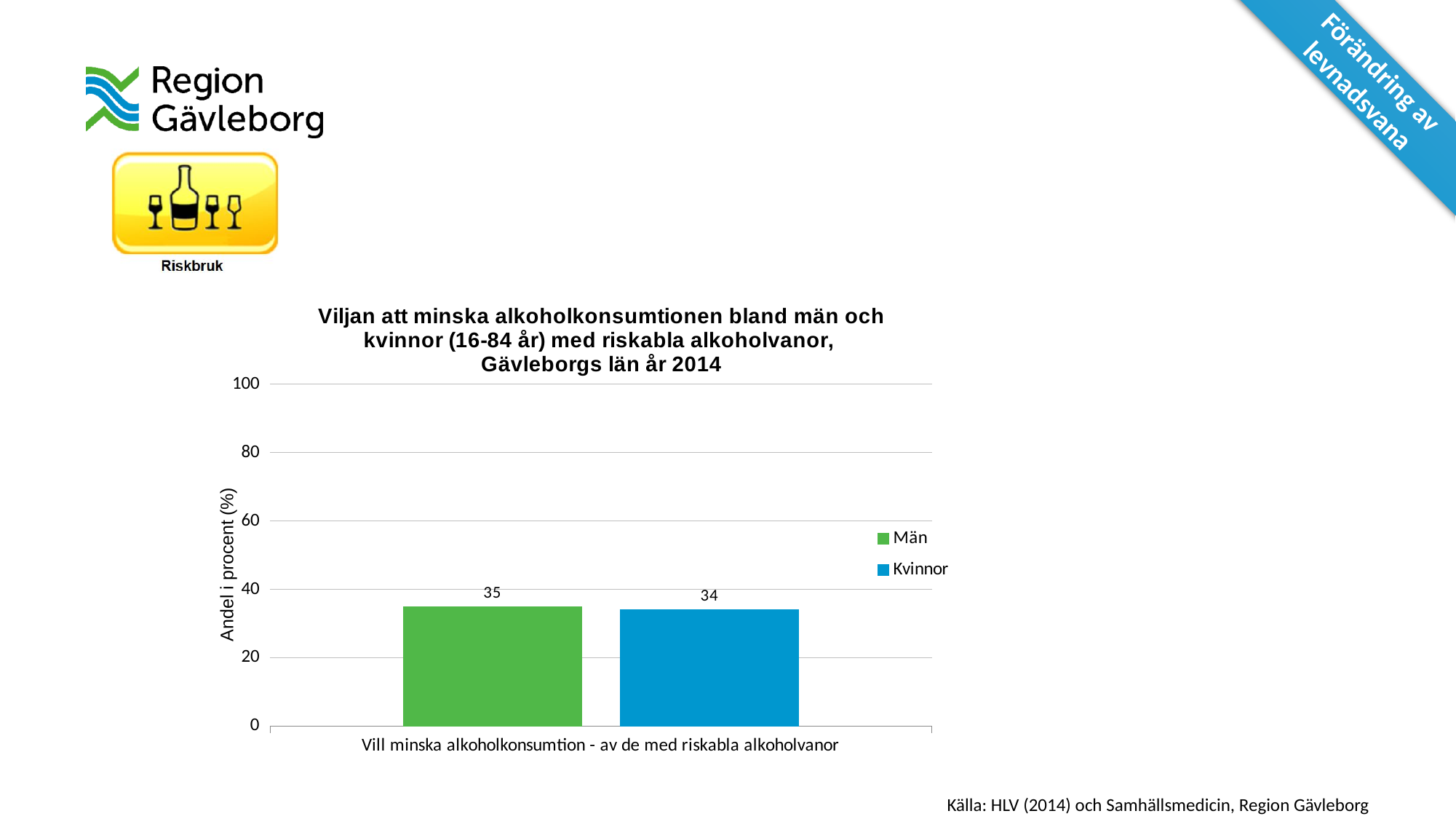
What is the value for Män in the chart? 35 What colour is the bar for Kvinnor? blue What is the difference between the values for Män and Kvinnor? 1 What is the highest value shown on the y axis? 100 How many series does the legend list? 2 How many categories are shown on the x axis? 1 Is the value for Kvinnor greater or less than 20? greater Is the value for Män greater or less than 40? less What kind of chart is shown on the slide? bar chart Which series has the higher value, Män or Kvinnor? Män What is the value for Kvinnor in the chart? 34 What is the label of the y axis? Andel i procent (%)